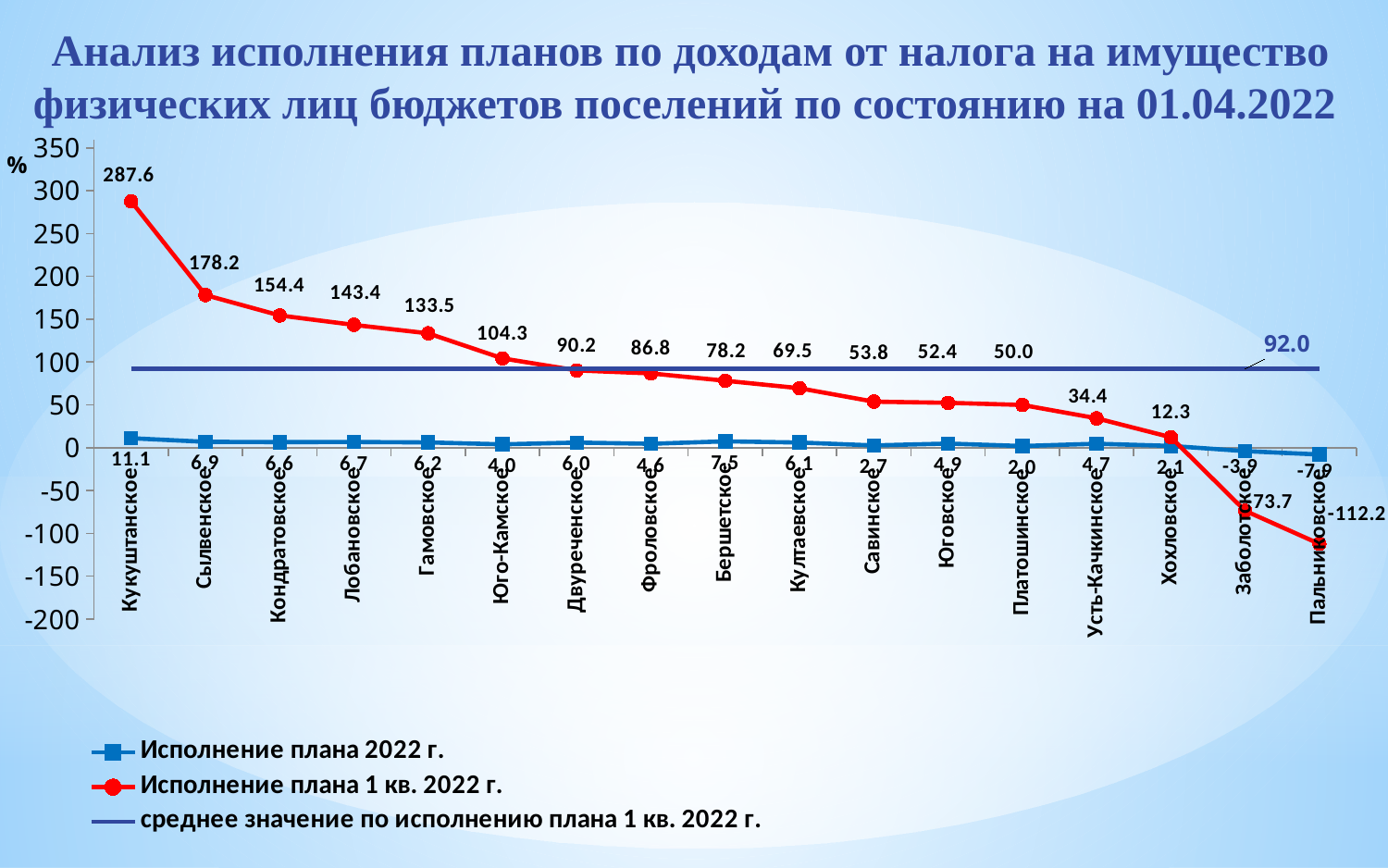
What is the value of 'Исполнение плана 2022 г.' for Кукуштанское? 11.1 What is the difference between the 'Исполнение плана 1 кв. 2022 г.' values for Сылвенское and Кондратовское? 23.8 How many settlements are shown on the x axis? 17 Which is larger for 'Исполнение плана 1 кв. 2022 г.': Гамовское or Двуреченское? Гамовское What is the value of 'Исполнение плана 1 кв. 2022 г.' for Кукуштанское? 287.6 What is the value of the average line 'среднее значение по исполнению плана 1 кв. 2022 г.'? 92.0 Which settlement has the lowest value for 'Исполнение плана 1 кв. 2022 г.'? Пальниковское How many series does the legend list? 3 What is the value of 'Исполнение плана 1 кв. 2022 г.' for Юго-Камское? 104.3 What kind of chart is shown on the slide? Line chart What is the value of 'Исполнение плана 1 кв. 2022 г.' for Пальниковское? -112.2 Which settlement has the highest value for 'Исполнение плана 1 кв. 2022 г.'? Кукуштанское